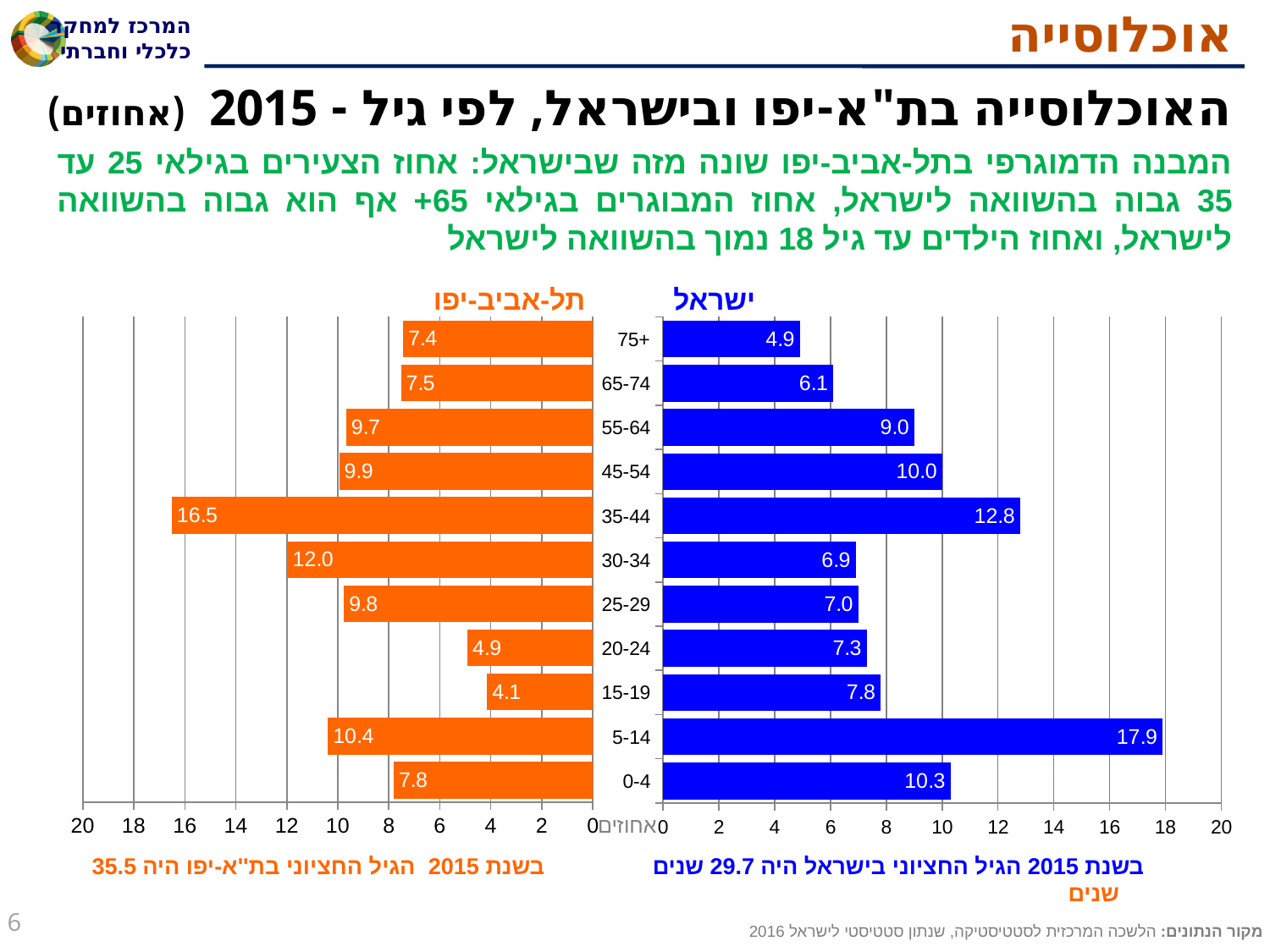
In the Tel Aviv-Yafo (תל-אביב-יפו) chart, which age group has the lowest value? 15-19 What is the difference between the Israel value and the Tel Aviv-Yafo value for the 5-14 age group? 7.5 In the Tel Aviv-Yafo (תל-אביב-יפו) chart, which age group has the highest value? 35-44 What is the difference between the Tel Aviv-Yafo value and the Israel value for the 35-44 age group? 3.7 In the Israel (ישראל) chart, what is the value for the 5-14 age group? 17.9 What kind of chart is used to show the age distribution on this slide? Bar chart For the 30-34 age group, which is larger: the Tel Aviv-Yafo value or the Israel value? Tel Aviv-Yafo For the 20-24 age group, which is larger: the Tel Aviv-Yafo value or the Israel value? Israel In the Israel (ישראל) chart, what is the value for the 75+ age group? 4.9 How many age groups are shown in the Israel (ישראל) chart? 11 In the Israel (ישראל) chart, which age group has the lowest value? 75+ In the Tel Aviv-Yafo (תל-אביב-יפו) chart, what is the value for the 35-44 age group? 16.5